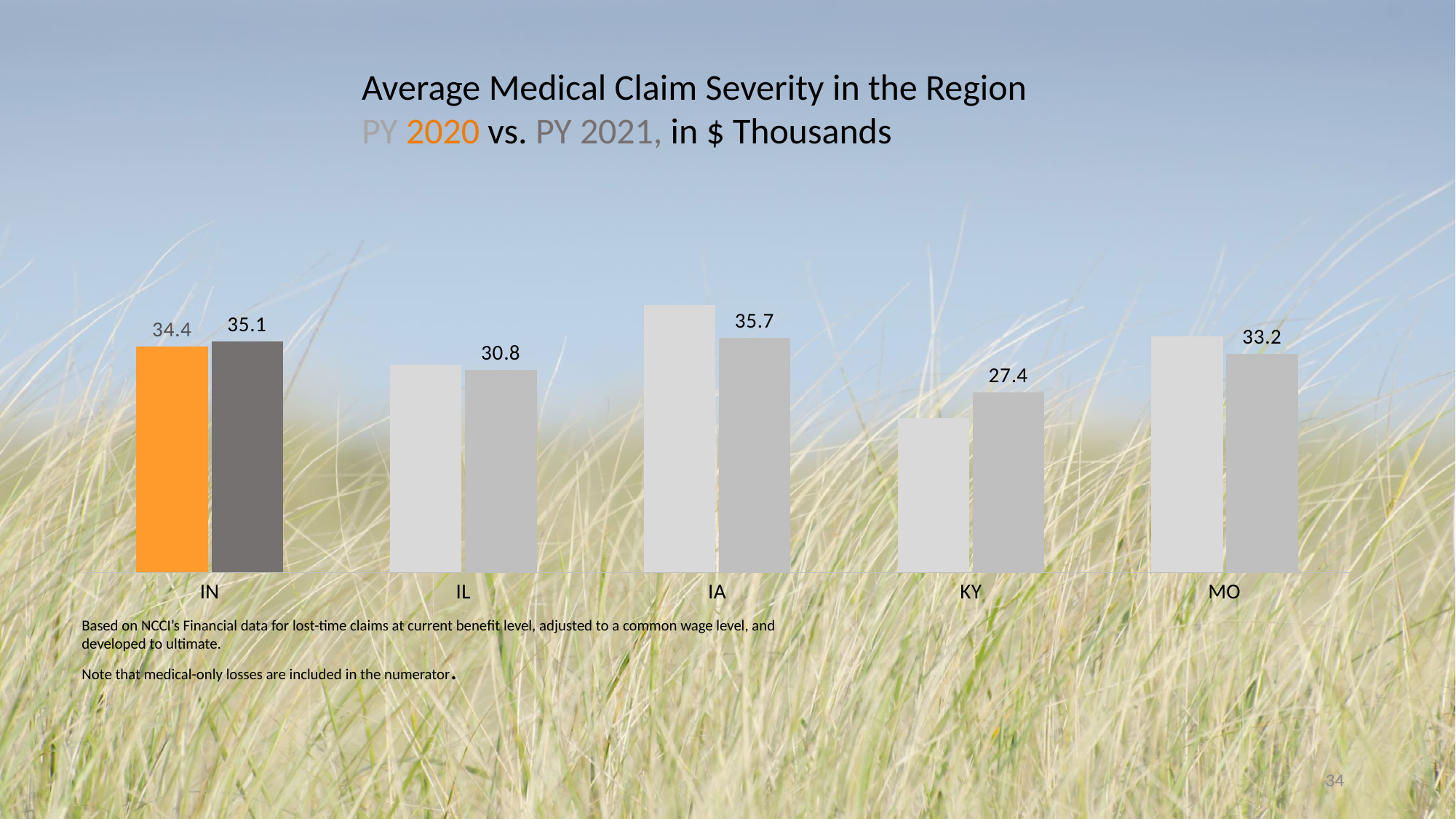
How many states are shown on the x axis? 5 What is the PY 2021 value for KY? 27.4 What is the difference between the PY 2021 and PY 2020 values for IN? 0.7 What is the PY 2021 value for IA? 35.7 What is the PY 2020 average medical claim severity for IN? 34.4 What is the difference between the PY 2021 values for IA and KY? 8.3 What is the PY 2021 value for MO? 33.2 What is the PY 2021 average medical claim severity for IN? 35.1 Which state has the lowest PY 2021 average medical claim severity? KY What kind of chart is shown on the slide? Bar chart For IN, which is larger: the PY 2020 value or the PY 2021 value? PY 2021 Which state has the highest PY 2021 average medical claim severity? IA